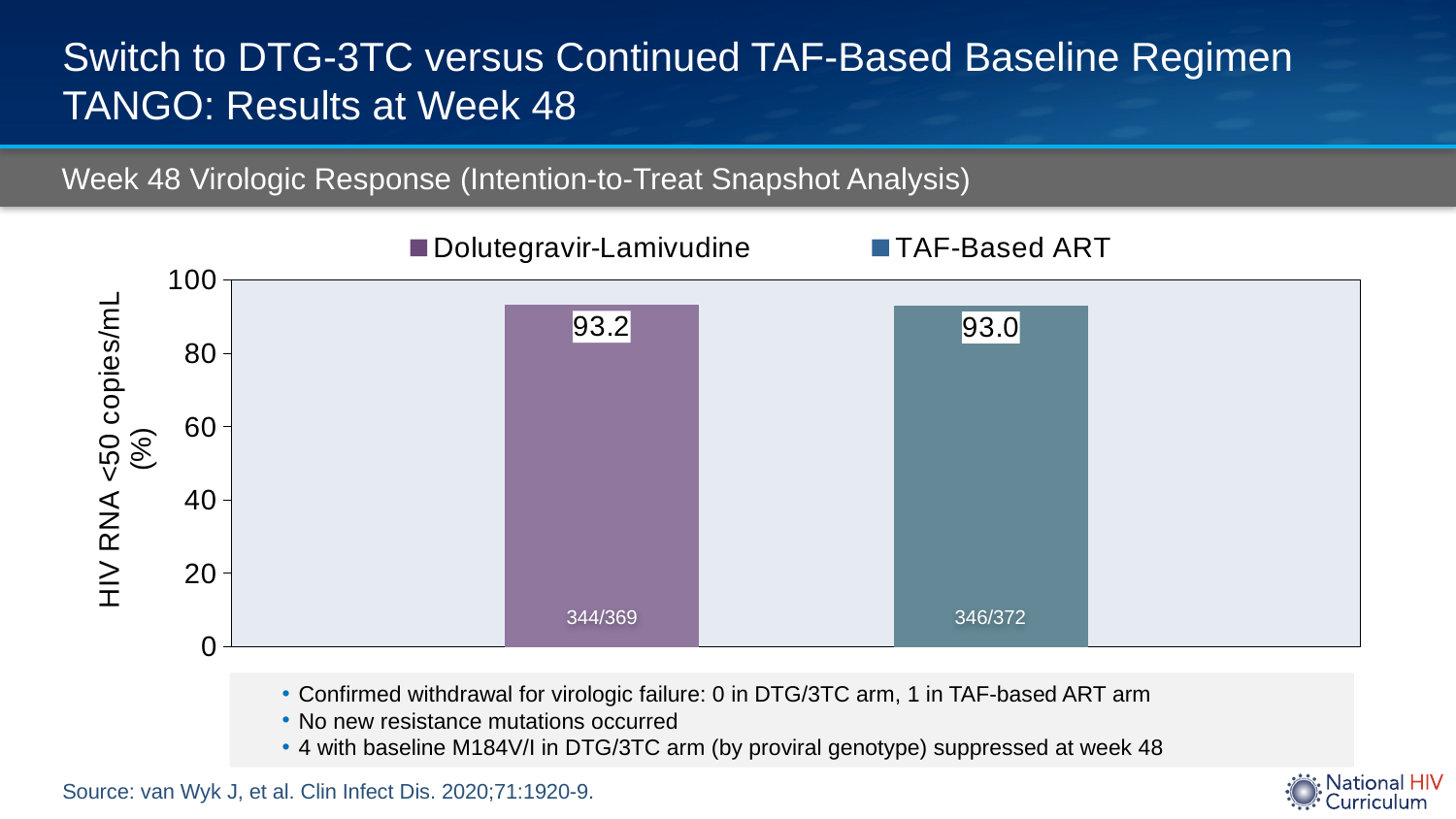
What is the value for Dolutegravir-Lamivudine? 93.2 Is the value for TAF-Based ART greater or less than 80? greater Is the value for Dolutegravir-Lamivudine greater or less than 100? less What is the value for TAF-Based ART? 93.0 What is the label of the y axis? HIV RNA <50 copies/mL (%) What kind of chart is shown? Bar chart What fraction of participants is shown inside the Dolutegravir-Lamivudine bar? 344/369 What is the difference between the Dolutegravir-Lamivudine and TAF-Based ART values? 0.2 What fraction of participants is shown inside the TAF-Based ART bar? 346/372 How many series does the legend list? 2 Which has the higher value, Dolutegravir-Lamivudine or TAF-Based ART? Dolutegravir-Lamivudine How many bars are plotted in the chart? 2